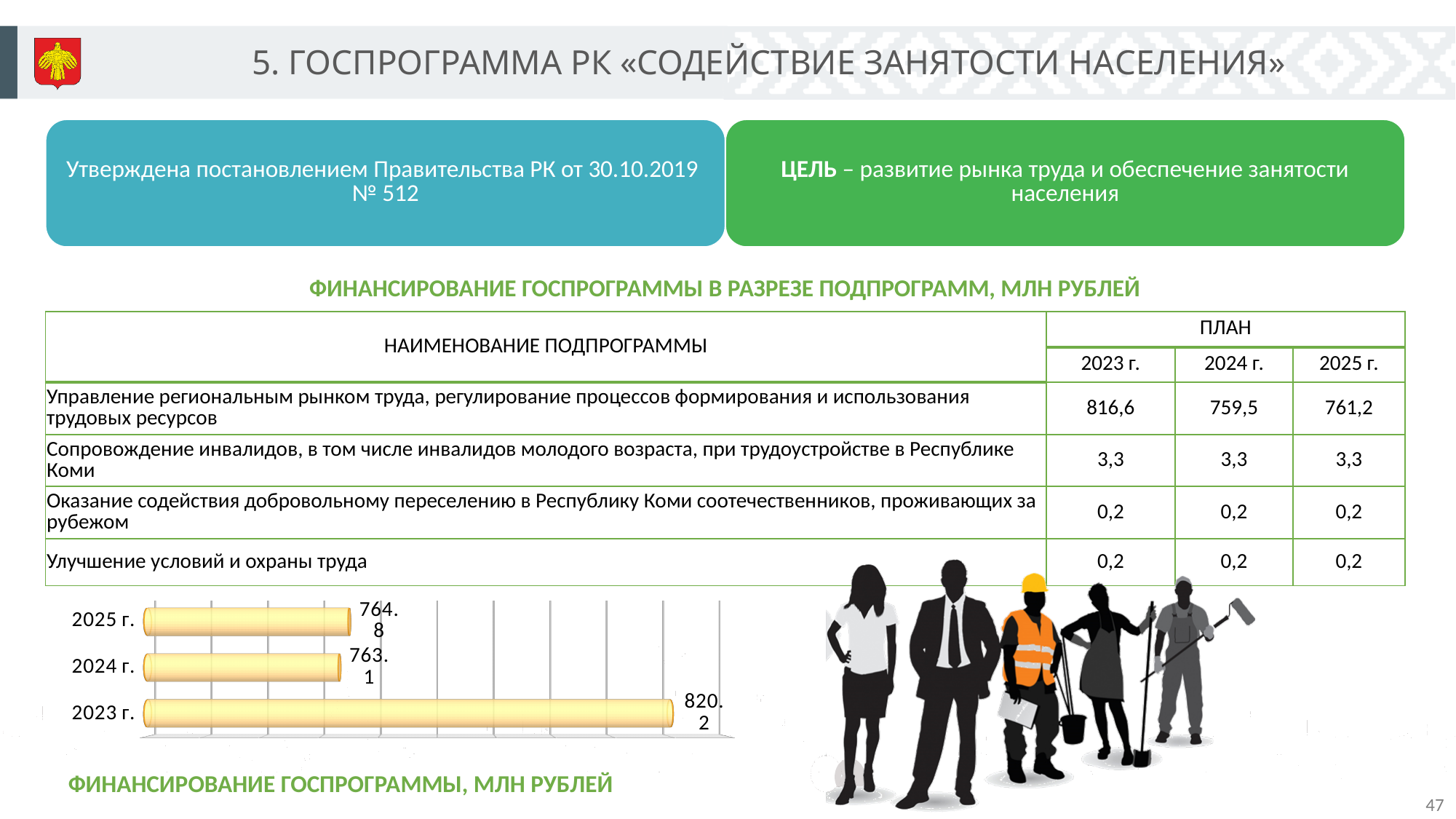
In the chart, what is the value for 2025 г.? 764.8 How many years (categories) are shown in the chart? 3 Which year has the highest value in the chart? 2023 г. Does the value in the chart rise or fall from 2023 г. to 2024 г.? fall In the chart, which is larger: the value for 2023 г. or the value for 2025 г.? 2023 г. What is the title of the chart at the bottom left of the slide? ФИНАНСИРОВАНИЕ ГОСПРОГРАММЫ, МЛН РУБЛЕЙ What is the difference between the values for 2025 г. and 2024 г. in the chart? 1.7 What type of chart is shown at the bottom left of the slide? bar chart In the chart, what is the value for 2023 г.? 820.2 Which year has the lowest value in the chart? 2024 г. What is the difference between the values for 2023 г. and 2024 г. in the chart? 57.1 In the chart, what is the value for 2024 г.? 763.1